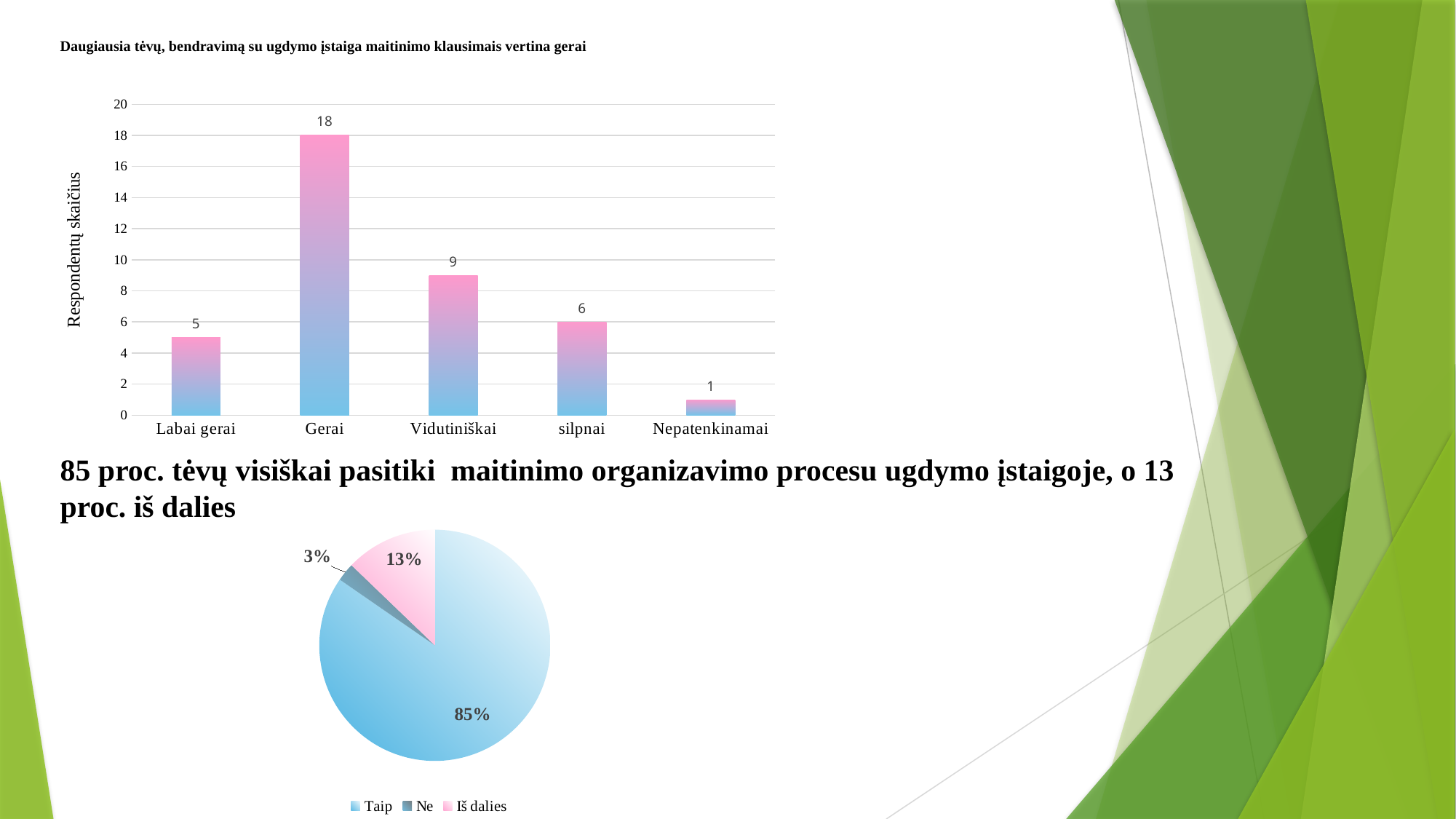
In the top bar chart, which category has the lowest value? Nepatenkinamai How many entries does the legend of the bottom pie chart list? 3 In the top bar chart, what is the value for Gerai? 18 In the top bar chart, what is the label of the vertical axis? Respondentų skaičius In the top bar chart, which category has the highest value? Gerai In the bottom pie chart, what share does the Taip slice have? 85% In the top bar chart, how many categories are shown on the x axis? 5 In the top bar chart, which is larger, the value for Labai gerai or the value for silpnai? silpnai What type of chart is the top chart on the slide? bar chart In the top bar chart, what is the difference between the values for Gerai and Vidutiniškai? 9 In the top bar chart, what is the value for Vidutiniškai? 9 In the bottom pie chart, what share does the Ne slice have? 3%